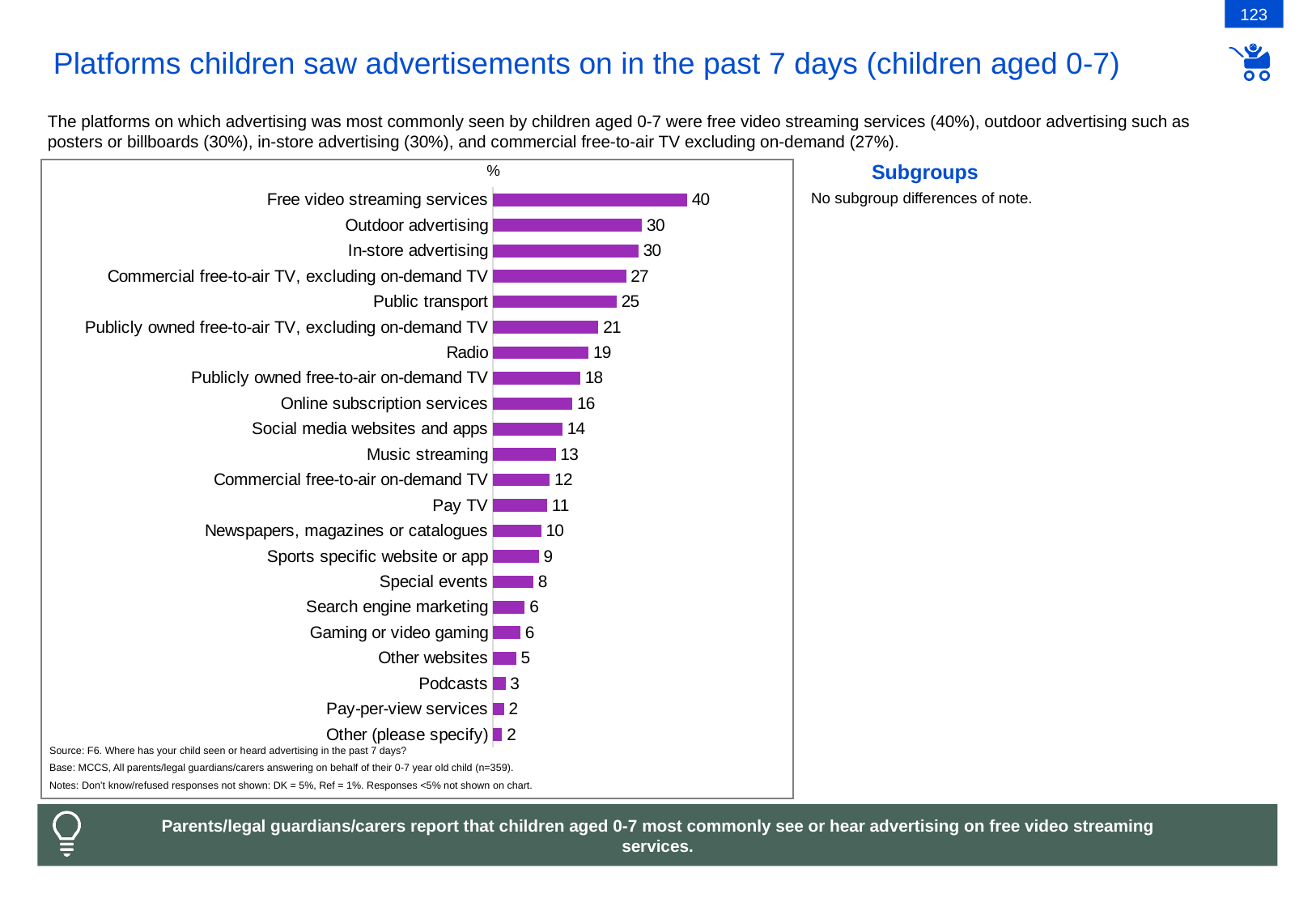
Which is larger, the value for Special events or the value for Other websites? Special events Which is larger, the value for Social media websites and apps or the value for Pay TV? Social media websites and apps What colour are the bars in the chart? Purple Which platform has the highest value? Free video streaming services What is the difference between the values for Radio and Music streaming? 6 What is the difference between the values for Free video streaming services and Outdoor advertising? 10 What is the value for Free video streaming services? 40 What kind of chart is shown on the slide? Bar chart What is the value for Podcasts? 3 What is the value for Public transport? 25 How many platforms are shown in the chart? 22 What is the value for Radio? 19